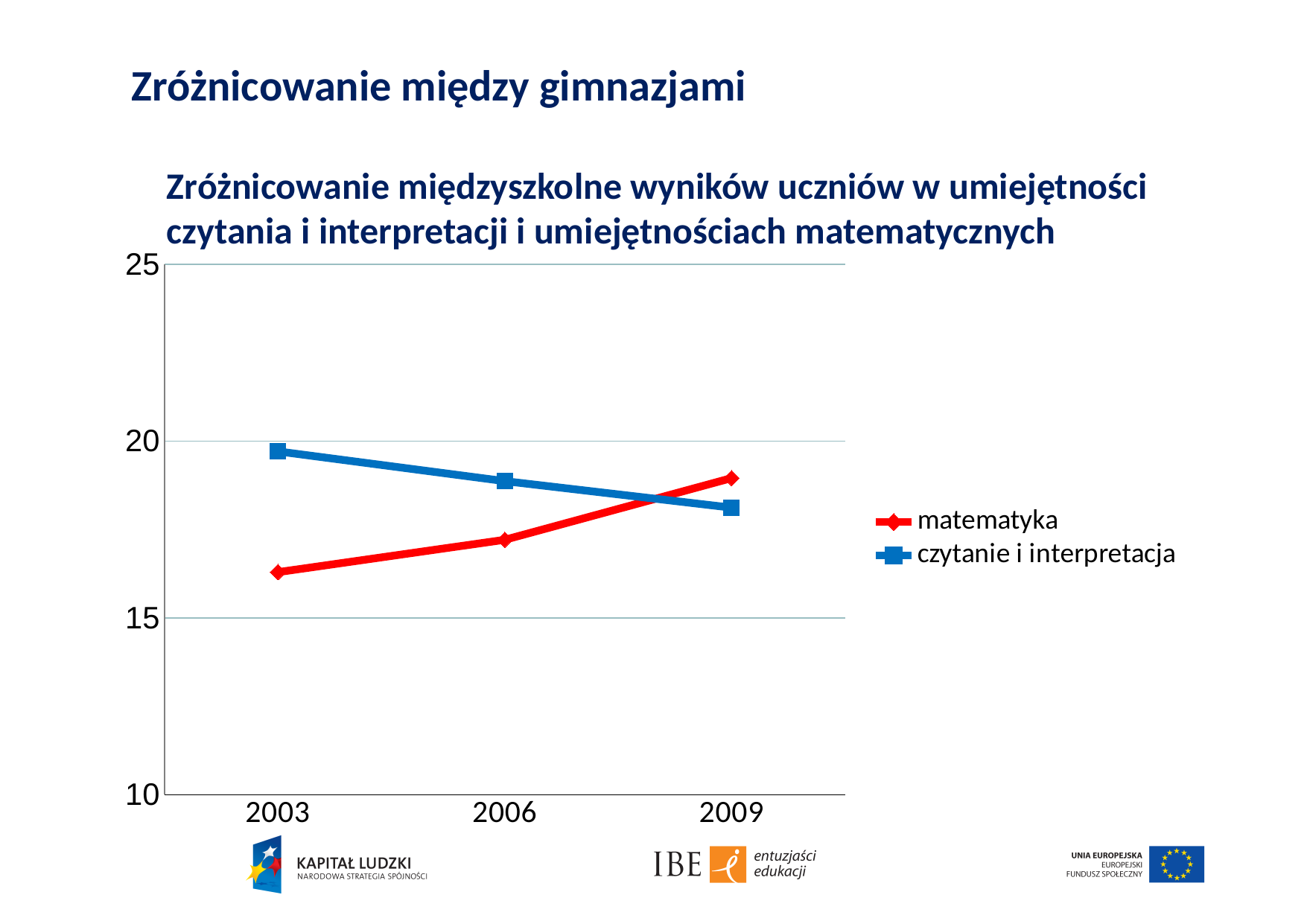
In which year is the value for matematyka highest? 2009 In which year is the value for czytanie i interpretacja lowest? 2009 In 2009, which series has the larger value, matematyka or czytanie i interpretacja? matematyka Is the value for matematyka in 2003 greater or less than 20? less What kind of chart is shown on the slide? line chart Which colour is used for the matematyka series? red Is the value for czytanie i interpretacja in 2009 greater or less than 15? greater How many series does the legend list? 2 Does the value for matematyka rise or fall from 2003 to 2009? rise Does the value for czytanie i interpretacja rise or fall from 2003 to 2009? fall How many years are plotted on the x axis? 3 In 2003, which series has the larger value, matematyka or czytanie i interpretacja? czytanie i interpretacja